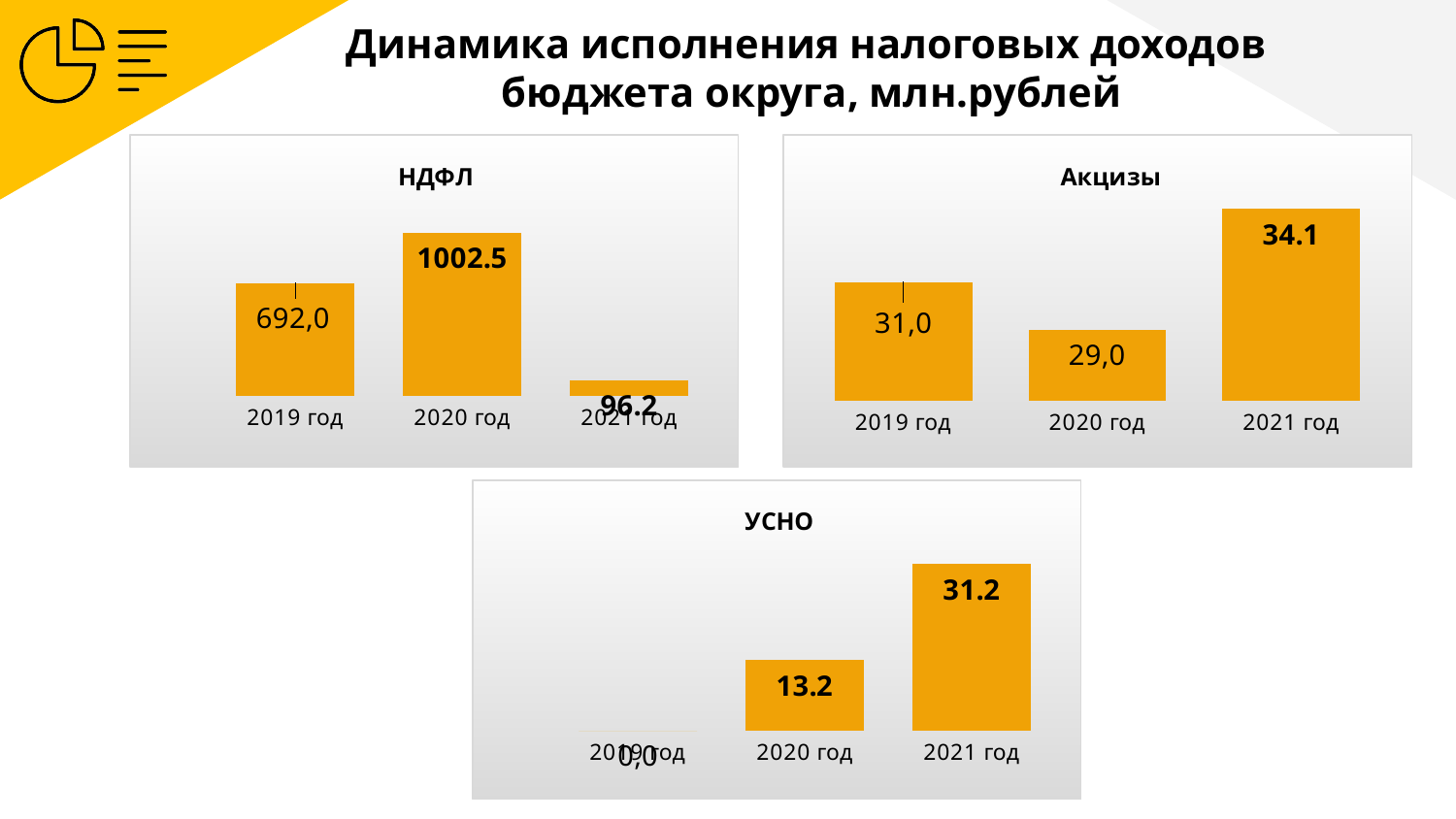
In the Акцизы chart, what is the difference between the 2019 год and 2020 год values? 2,0 In the Акцизы chart, what is the value for 2021 год? 34.1 In the Акцизы chart, which year has the highest value? 2021 год How many years are shown in the УСНО chart? 3 In the НДФЛ chart, what is the value for 2019 год? 692,0 In the Акцизы chart, which is larger, the value for 2019 год or 2020 год? 2019 год In the НДФЛ chart, which year has the lowest value? 2021 год In the УСНО chart, do the values rise or fall from 2019 год to 2021 год? rise In the НДФЛ chart, what is the difference between the 2020 год and 2019 год values? 310.5 What type of chart is the Акцизы chart? bar chart In the НДФЛ chart, what is the value for 2020 год? 1002.5 In the УСНО chart, what is the value for 2020 год? 13.2